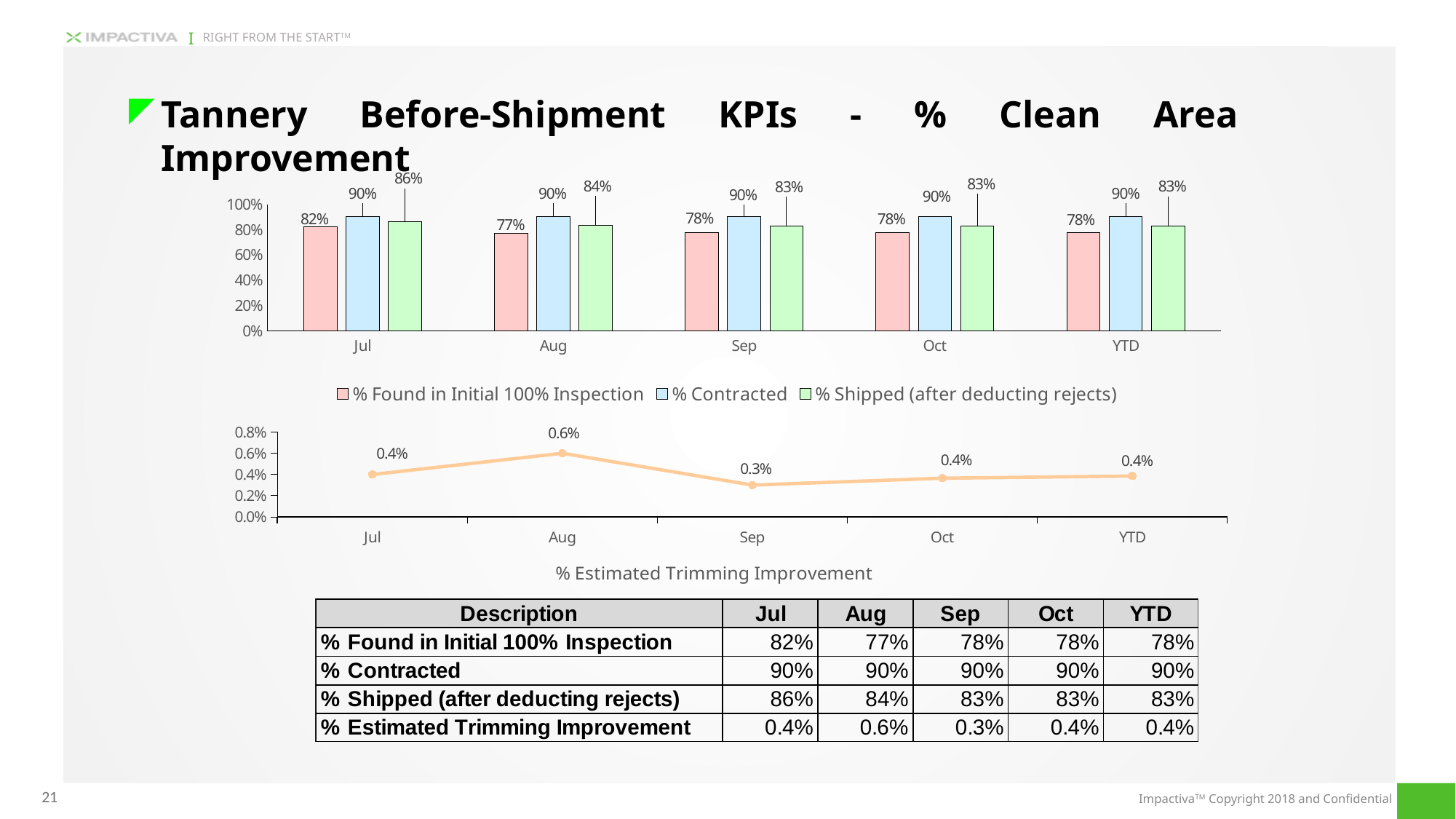
In the top bar chart, which month has the lowest value for % Found in Initial 100% Inspection? Aug In the bottom line chart (% Estimated Trimming Improvement), what is the value for Aug? 0.6% What kind of chart is the top chart on the slide? bar chart How many points are plotted in the bottom line chart (% Estimated Trimming Improvement)? 5 In the bottom line chart (% Estimated Trimming Improvement), what is the difference between the Aug and Sep values? 0.3% In the bottom line chart (% Estimated Trimming Improvement), which month has the lowest value? Sep In the top bar chart, what is the value of % Found in Initial 100% Inspection for Jul? 82% In the top bar chart, which is larger for Jul: % Shipped (after deducting rejects) or % Found in Initial 100% Inspection? % Shipped (after deducting rejects) In the top bar chart, what is the value of % Contracted for Oct? 90% In the top bar chart, what is the value of % Shipped (after deducting rejects) for Aug? 84% How many series does the legend of the top bar chart list? 3 In the top bar chart, what is the difference between % Contracted and % Found in Initial 100% Inspection for Sep? 12%